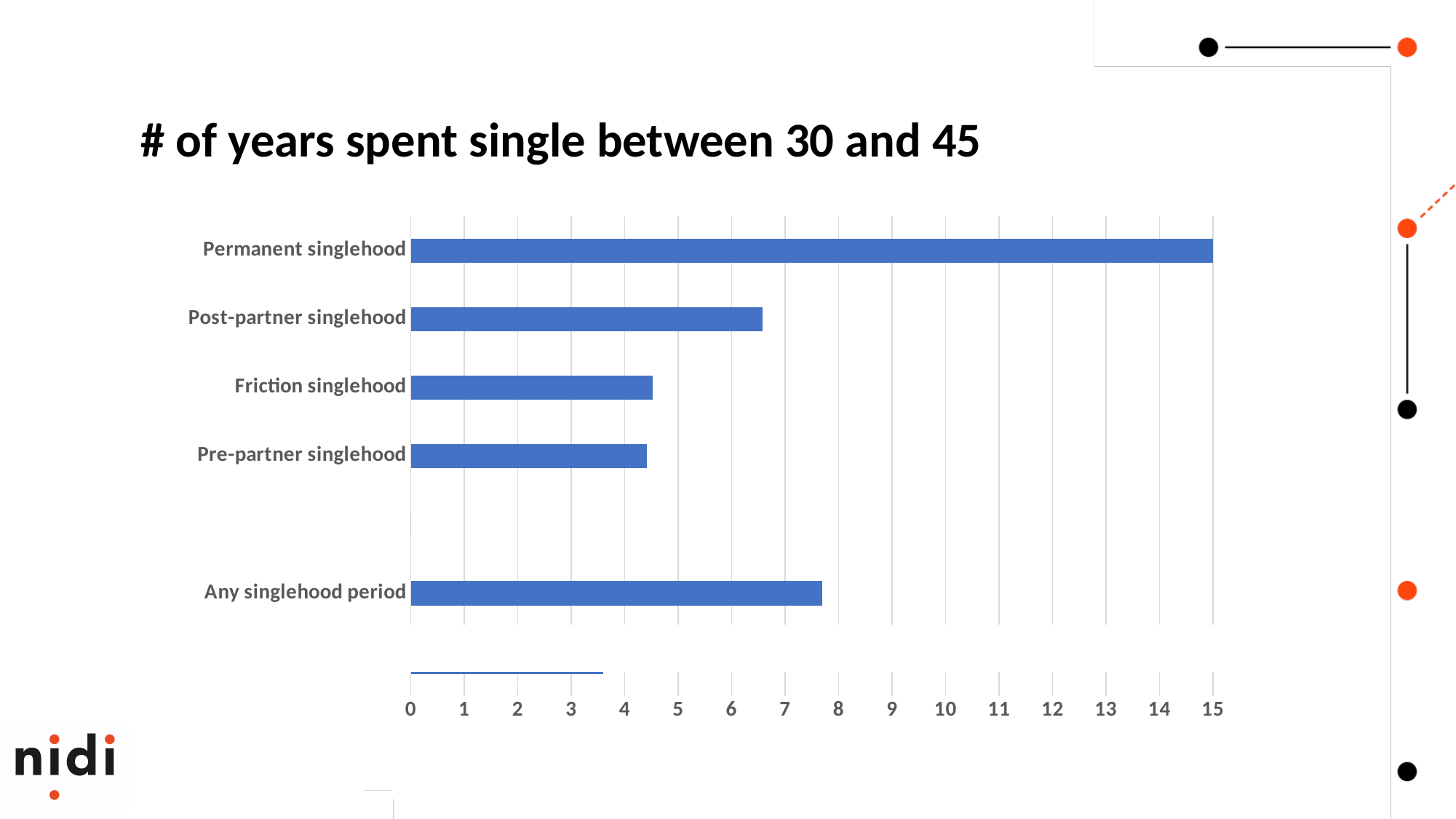
What is the highest value shown on the horizontal axis? 15 Is the value for Post-partner singlehood greater or less than 6? greater What is the title of the chart? # of years spent single between 30 and 45 What is the value for Permanent singlehood? 15 Is the value for Any singlehood period greater or less than 8? less Which is larger, the value for Post-partner singlehood or the value for Any singlehood period? Any singlehood period Is the value for Pre-partner singlehood greater or less than 4? greater What kind of chart is shown on the slide? bar chart Which is larger, the value for Post-partner singlehood or the value for Friction singlehood? Post-partner singlehood How many categories are plotted in the chart? 5 Which category has the highest value? Permanent singlehood